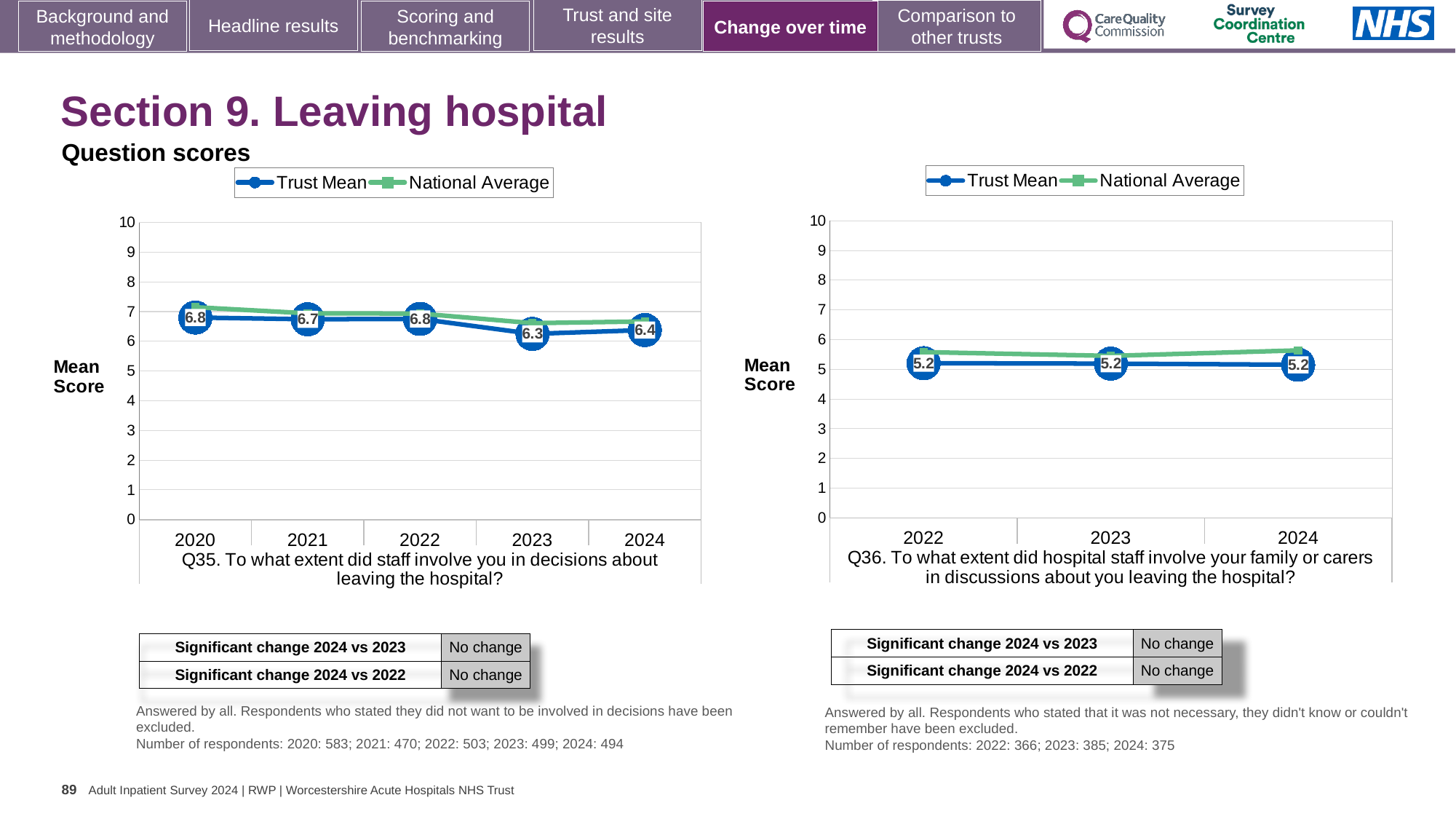
In the Q35 chart, which year has the lowest Trust Mean score? 2023 How many series does the legend of the Q36 chart list? 2 In the Q35 chart, what is the Trust Mean score for 2024? 6.4 What kind of chart is the Q35 chart? Line chart In the Q35 chart, what is the Trust Mean score for 2023? 6.3 In the Q36 chart, is the National Average for 2022 greater or less than 6? less In the Q36 chart, what is the Trust Mean score for 2024? 5.2 In the Q35 chart, what is the Trust Mean score for 2020? 6.8 In the Q35 chart, how many years are plotted on the x axis? 5 In the Q36 chart, how many years are plotted on the x axis? 3 In the Q35 chart, is the Trust Mean score for 2021 larger than the Trust Mean score for 2024? Yes In the Q35 chart, what is the difference between the Trust Mean scores for 2022 and 2023? 0.5